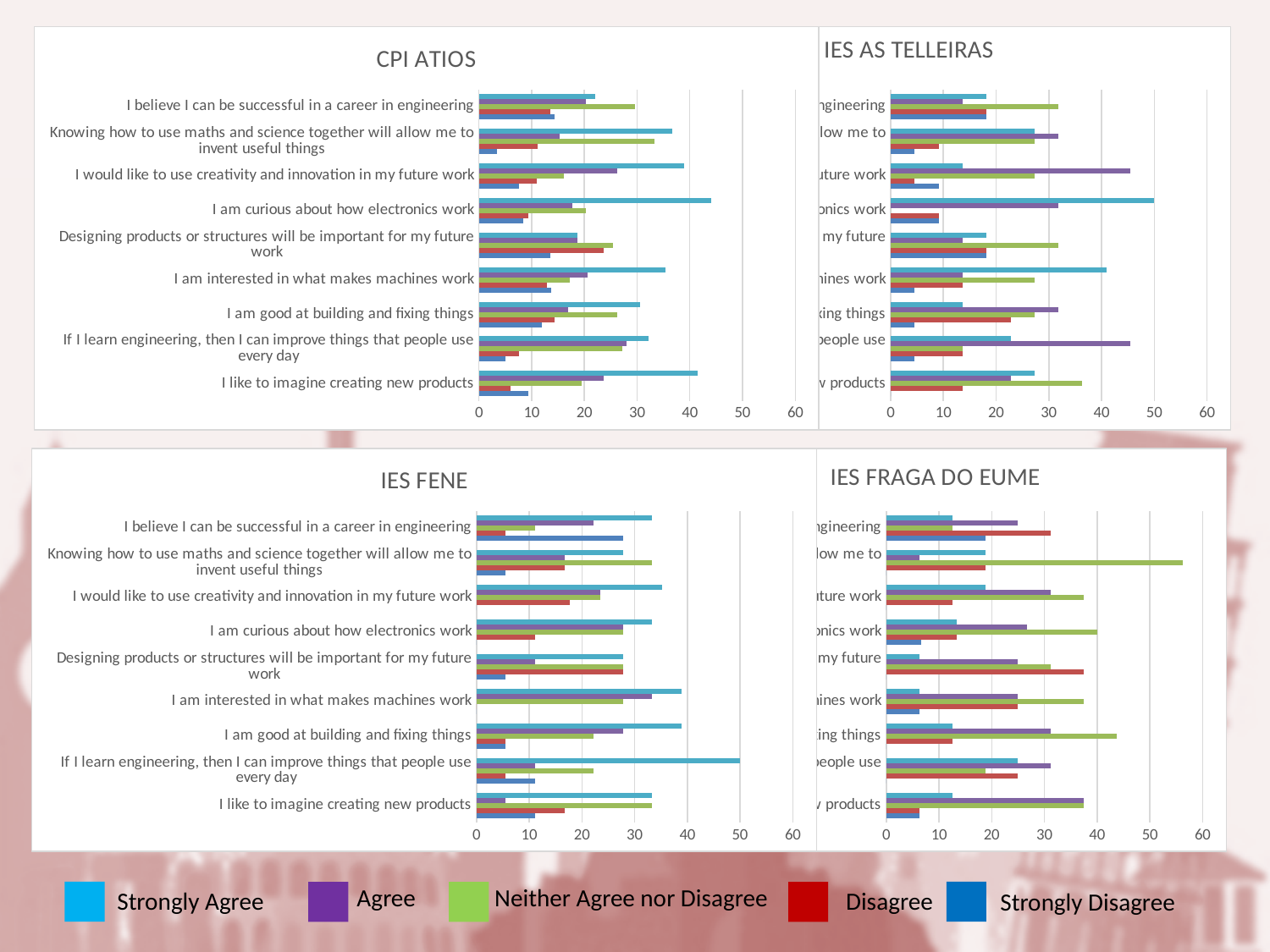
Which colour represents Disagree in the legend? red How many statement categories are plotted in the IES FENE chart? 9 In the IES FENE chart, which statement has the highest Strongly Agree value? If I learn engineering, then I can improve things that people use every day What is the title of the top-left chart? CPI ATIOS In the CPI ATIOS chart, for 'I am curious about how electronics work', which is larger: Strongly Agree or Agree? Strongly Agree How many series does the legend at the bottom of the slide list? 5 In the IES FENE chart, is the Strongly Agree value for 'If I learn engineering, then I can improve things that people use every day' greater or less than 40? greater In the CPI ATIOS chart, is the Strongly Agree value for 'I believe I can be successful in a career in engineering' greater or less than 30? less In the IES FRAGA DO EUME chart, is the Neither Agree nor Disagree value for the second category from the top greater or less than 50? greater What kind of chart is the CPI ATIOS chart? bar chart